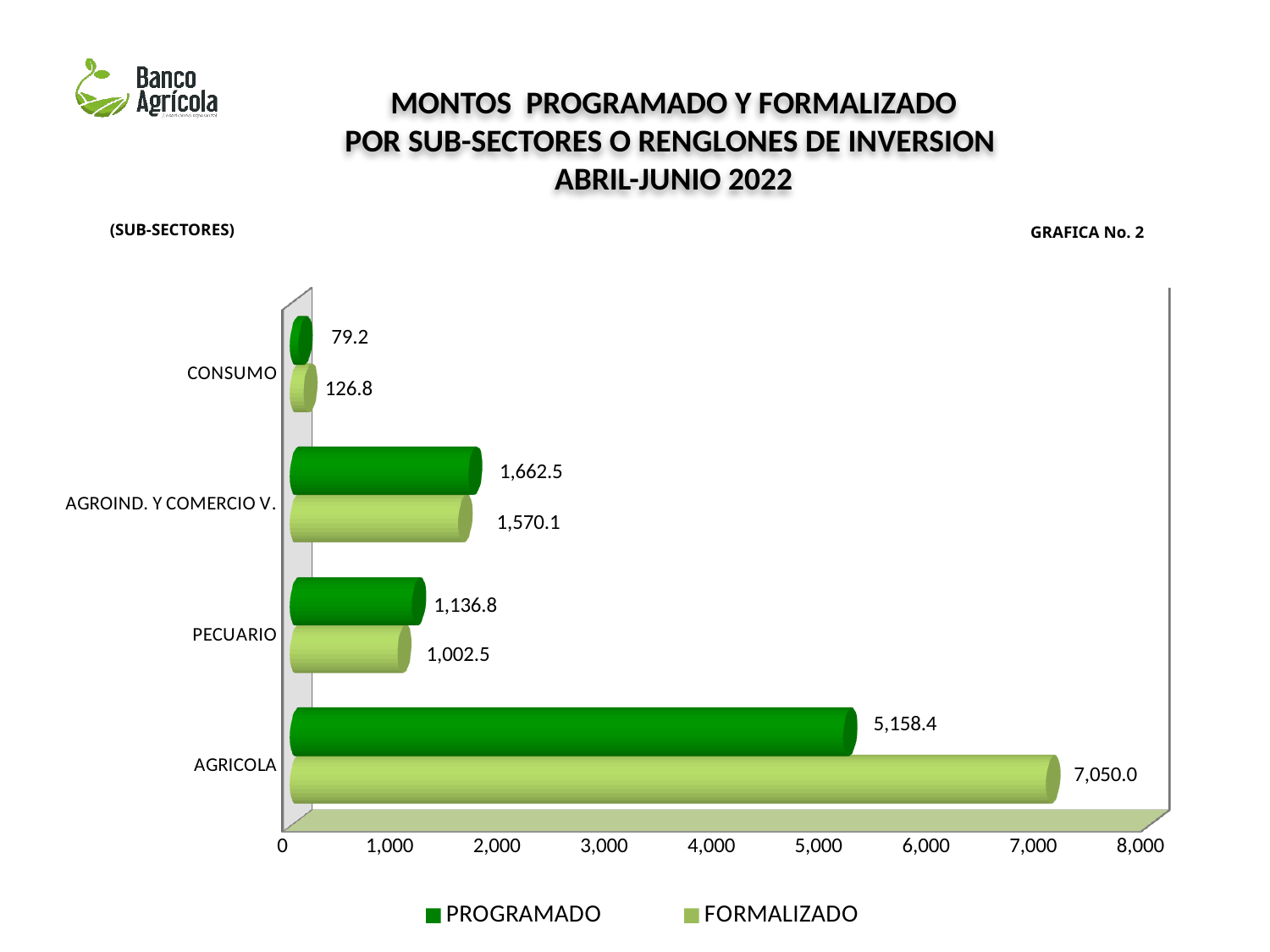
How many series does the legend list? 2 What kind of chart is shown on the slide? Bar chart What is the PROGRAMADO value for AGRICOLA? 5,158.4 What is the FORMALIZADO value for AGROIND. Y COMERCIO V.? 1,570.1 Which sub-sector has the lowest PROGRAMADO value? CONSUMO How many sub-sectors are shown on the chart? 4 What is the FORMALIZADO value for CONSUMO? 126.8 What is the difference between the FORMALIZADO and PROGRAMADO values for AGRICOLA? 1,891.6 Which series is shown in dark green in the legend? PROGRAMADO Which sub-sector has the highest FORMALIZADO value? AGRICOLA What is the PROGRAMADO value for PECUARIO? 1,136.8 For PECUARIO, which is larger: PROGRAMADO or FORMALIZADO? PROGRAMADO